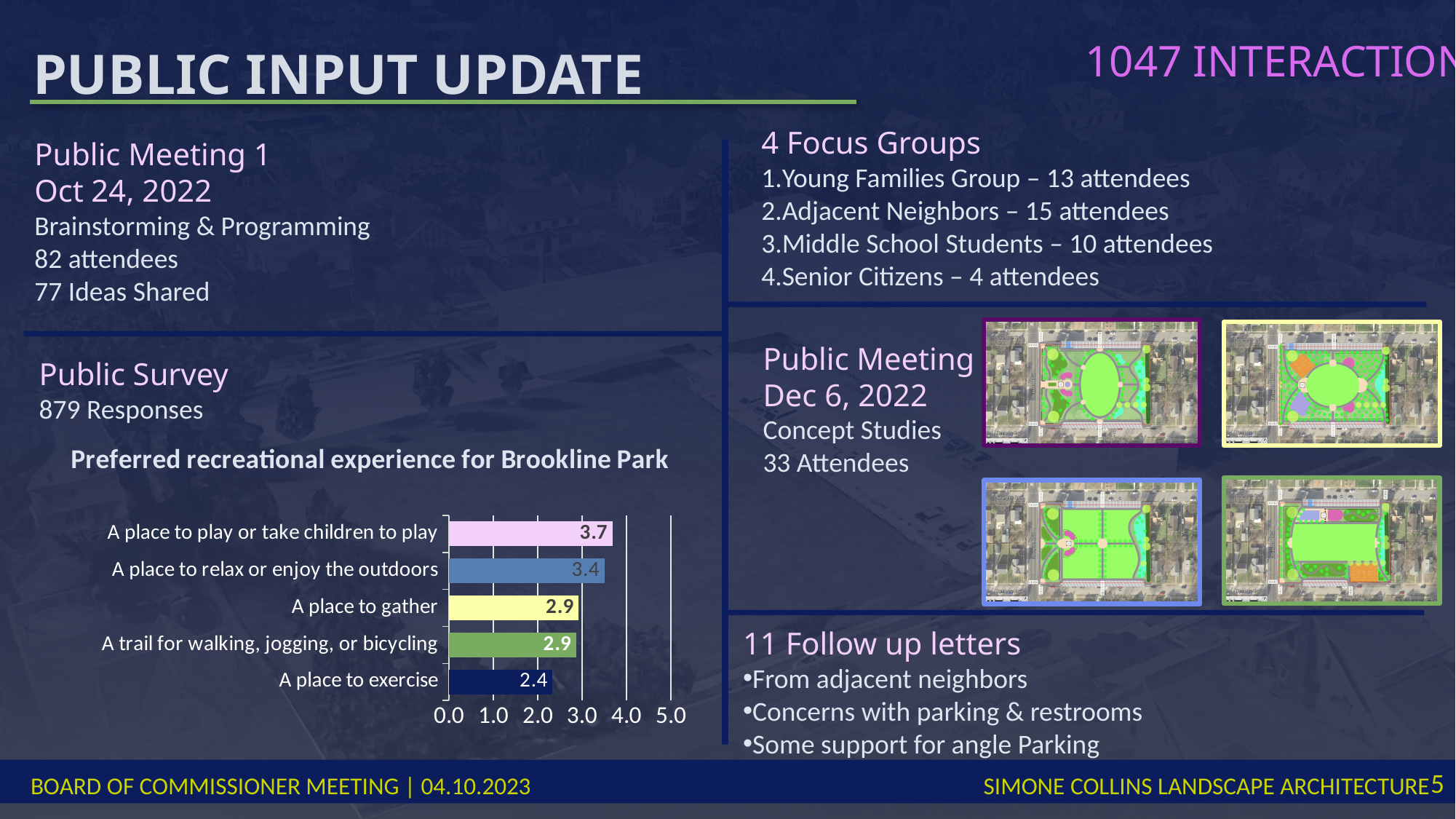
What is the value for 'A place to play or take children to play' in the Preferred recreational experience chart? 3.7 What kind of chart is used to show the preferred recreational experience? bar chart What is the value for 'A place to exercise'? 2.4 What is the maximum value shown on the chart's x axis? 5.0 Which category has the highest value in the chart? A place to play or take children to play How many categories are shown in the bar chart? 5 Which category has the lowest value in the chart? A place to exercise What is the title of the chart? Preferred recreational experience for Brookline Park Is the value for 'A place to gather' greater or less than 2.0? greater What is the difference between the values for 'A place to play or take children to play' and 'A place to exercise'? 1.3 Which is larger: the value for 'A place to relax or enjoy the outdoors' or 'A place to gather'? A place to relax or enjoy the outdoors What is the value for 'A place to relax or enjoy the outdoors'? 3.4